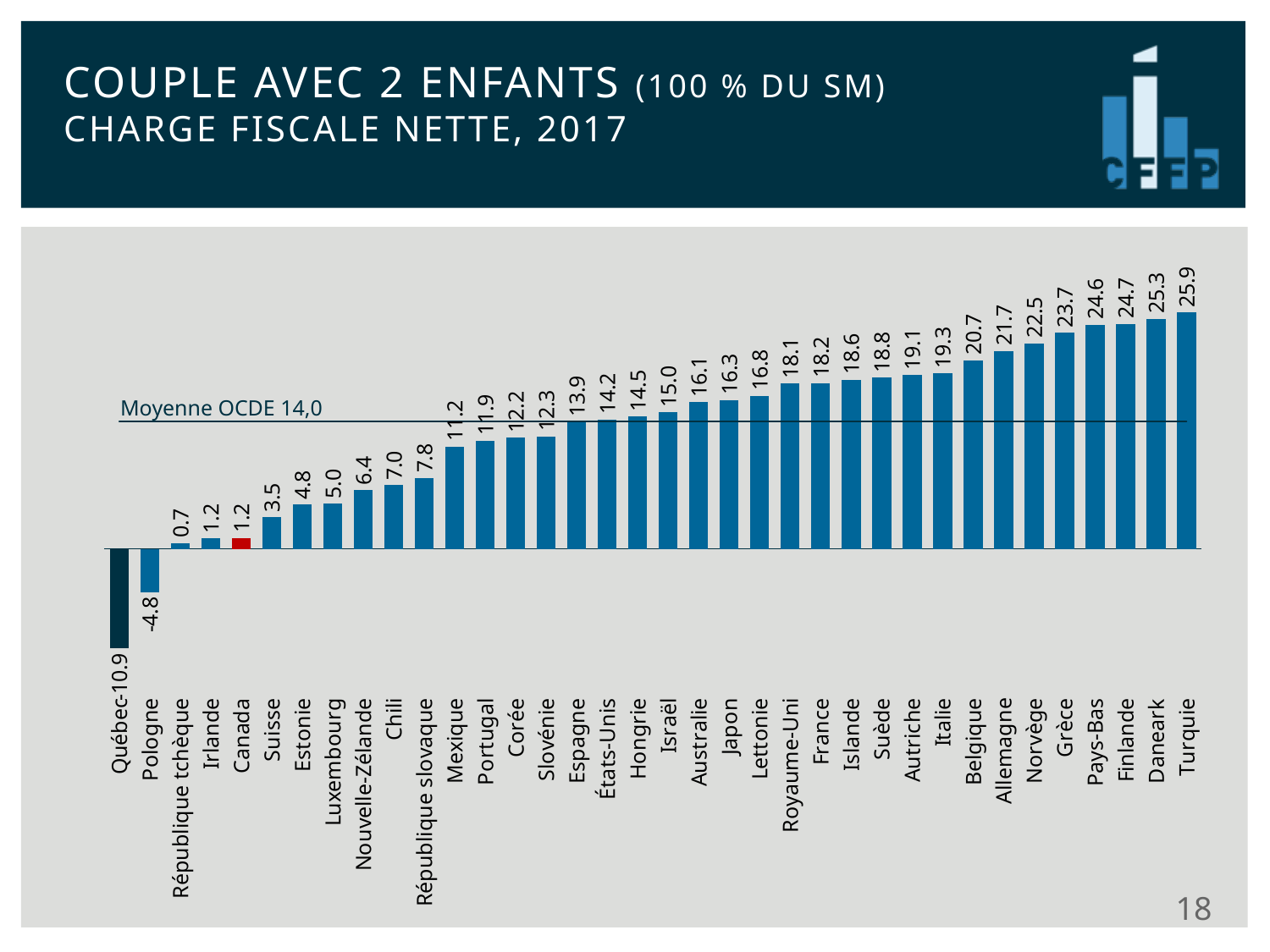
Which category has the highest value? Turquie How many categories are shown on the chart? 36 What is the difference between the values for Turquie and Québec? 36.8 Which is larger, the value for Pologne or the value for Suisse? Suisse Which category has the lowest value? Québec What kind of chart is shown on the slide? Bar chart What is the OECD average (Moyenne OCDE) indicated by the horizontal line? 14,0 What is the value for Québec? -10.9 What is the value for Mexique? 11.2 What is the difference between the values for Allemagne and Belgique? 1.0 What is the value for Canada? 1.2 What is the value for France? 18.2